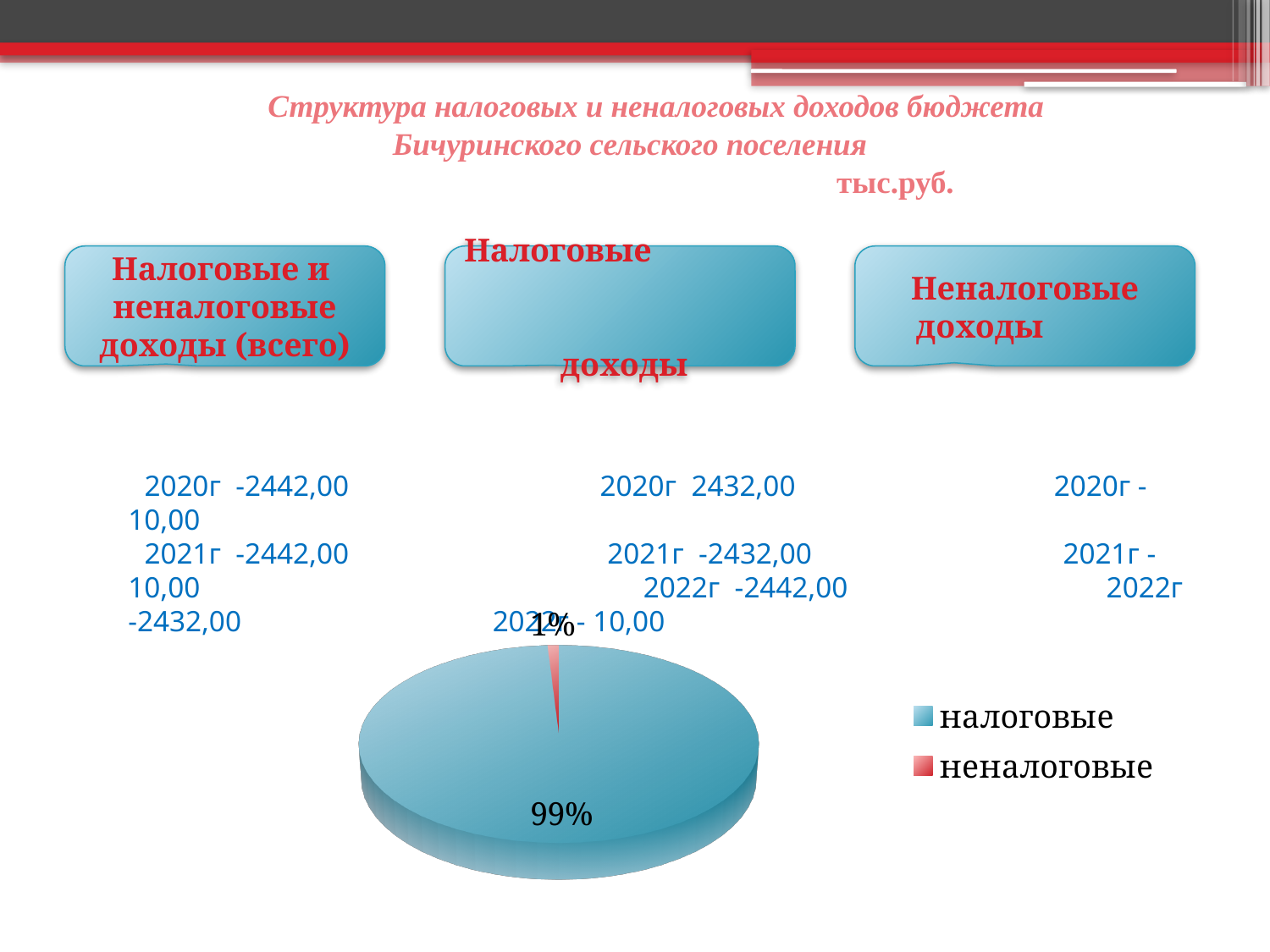
What is the difference in percentage points between the "налоговые" and "неналоговые" slices? 98 What colour is the "налоговые" slice in the pie chart? blue What share of the pie does the "неналоговые" slice represent? 1% How many entries does the legend of the pie chart list? 2 Which slice of the pie chart is the smallest? неналоговые How many slices does the pie chart have? 2 Which is larger in the pie chart, the "налоговые" slice or the "неналоговые" slice? налоговые What share of the pie does the "налоговые" slice represent? 99% What colour is the "неналоговые" slice in the pie chart? red Which slice of the pie chart is the largest? налоговые What kind of chart is shown on the slide? pie chart